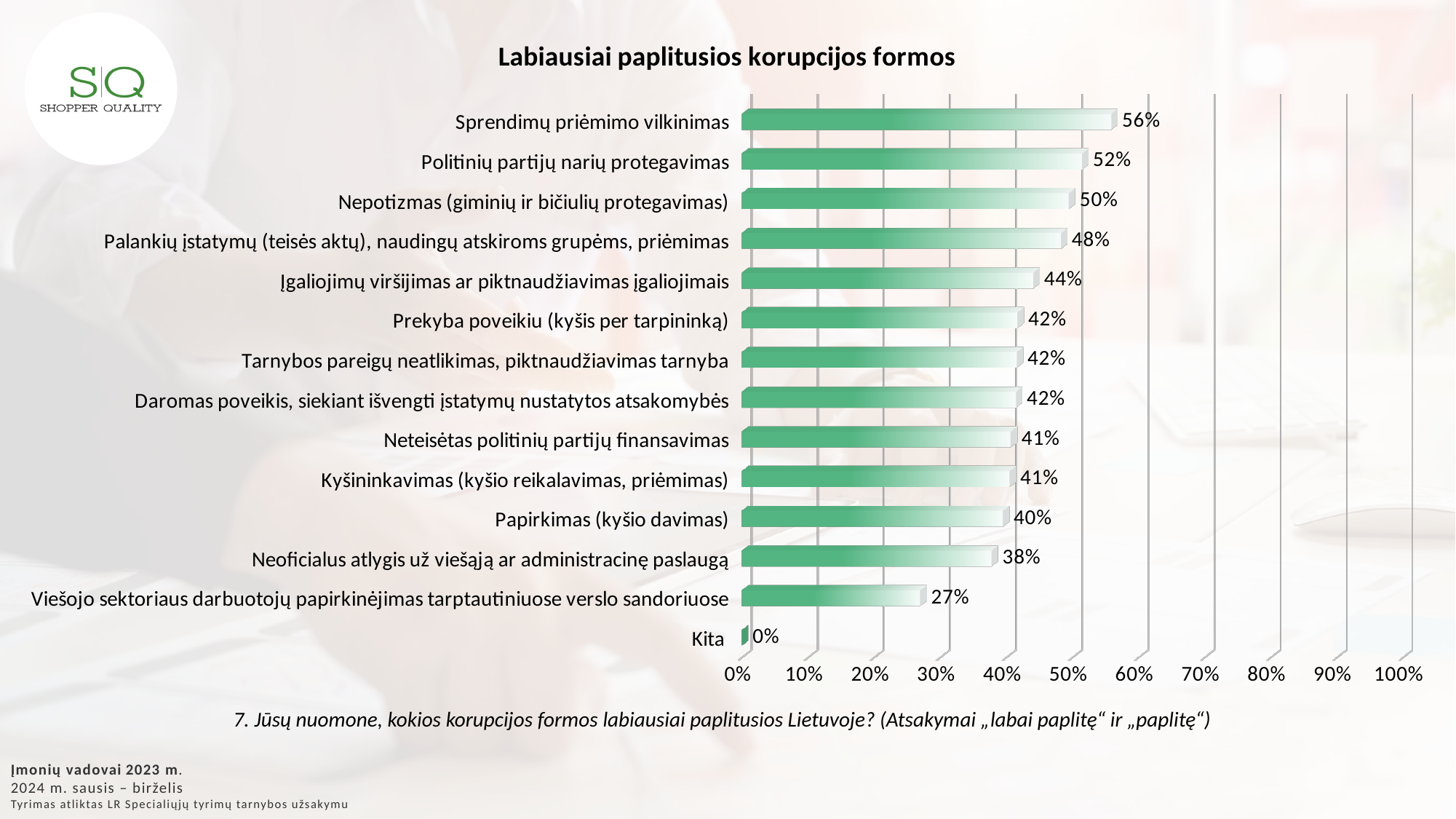
What is the difference between "Sprendimų priėmimo vilkinimas" and "Politinių partijų narių protegavimas"? 4% What is the title of the chart? Labiausiai paplitusios korupcijos formos Is the value for "Palankių įstatymų (teisės aktų), naudingų atskiroms grupėms, priėmimas" greater or less than 50%? less How many categories are shown in the chart? 14 What is the value for "Viešojo sektoriaus darbuotojų papirkinėjimas tarptautiniuose verslo sandoriuose"? 27% What is the value for "Sprendimų priėmimo vilkinimas"? 56% What kind of chart is shown on the slide? bar chart What is the value for "Nepotizmas (giminių ir bičiulių protegavimas)"? 50% Which category has the lowest value? Kita Which category has the highest value? Sprendimų priėmimo vilkinimas What is the value for "Papirkimas (kyšio davimas)"? 40% Which is larger: "Neoficialus atlygis už viešąją ar administracinę paslaugą" or "Įgaliojimų viršijimas ar piktnaudžiavimas įgaliojimais"? Įgaliojimų viršijimas ar piktnaudžiavimas įgaliojimais